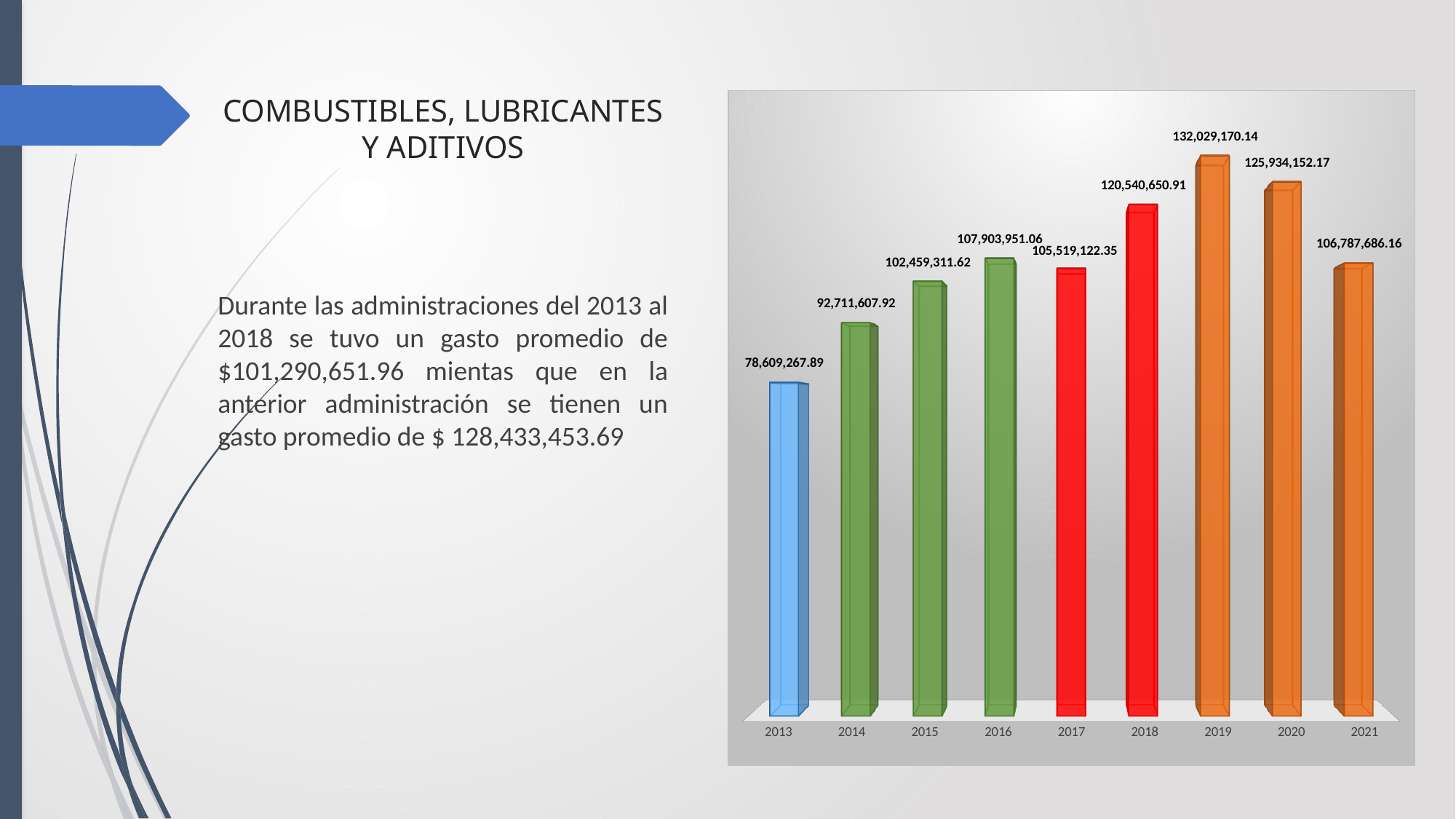
How many years are shown on the x axis? 9 Which is larger, the value for 2016 or the value for 2017? 2016 What is the difference between the values for 2014 and 2013? 14,102,340.03 Which is larger, the value for 2020 or the value for 2021? 2020 Which year has the lowest value? 2013 What is the value shown for 2018? 120,540,650.91 Which year has the highest value? 2019 What is the difference between the values for 2019 and 2013? 53,419,902.25 What is the value shown for 2021? 106,787,686.16 What kind of chart is shown? Bar chart Do the values rise or fall from 2013 to 2016? Rise What is the value shown for 2013? 78,609,267.89